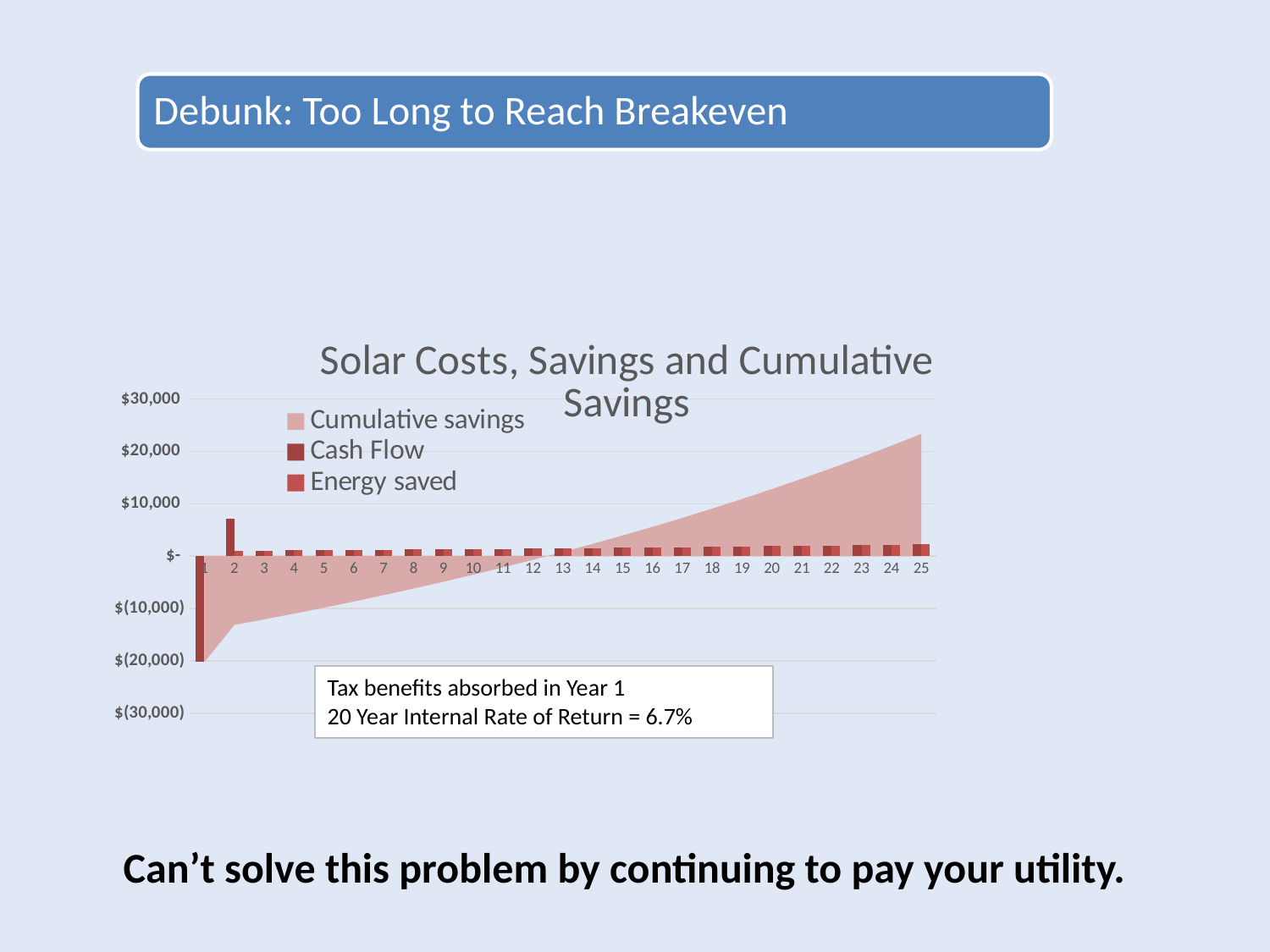
Does the Cumulative savings series rise or fall from year 2 to year 25? rise What is the title of the chart? Solar Costs, Savings and Cumulative Savings Is the Cumulative savings value for year 25 greater or less than $20,000? greater Which year has the highest Cash Flow value? 2 Which year has the lowest Cash Flow value? 1 Which is larger, the Cash Flow value for year 1 or for year 2? year 2 Is the Cash Flow value for year 1 greater or less than $(10,000)? less How many series does the chart legend list? 3 According to the text box on the chart, what is the 20 Year Internal Rate of Return? 6.7% Is the Cumulative savings value for year 2 greater or less than $(10,000)? less How many years are shown along the x axis of the chart? 25